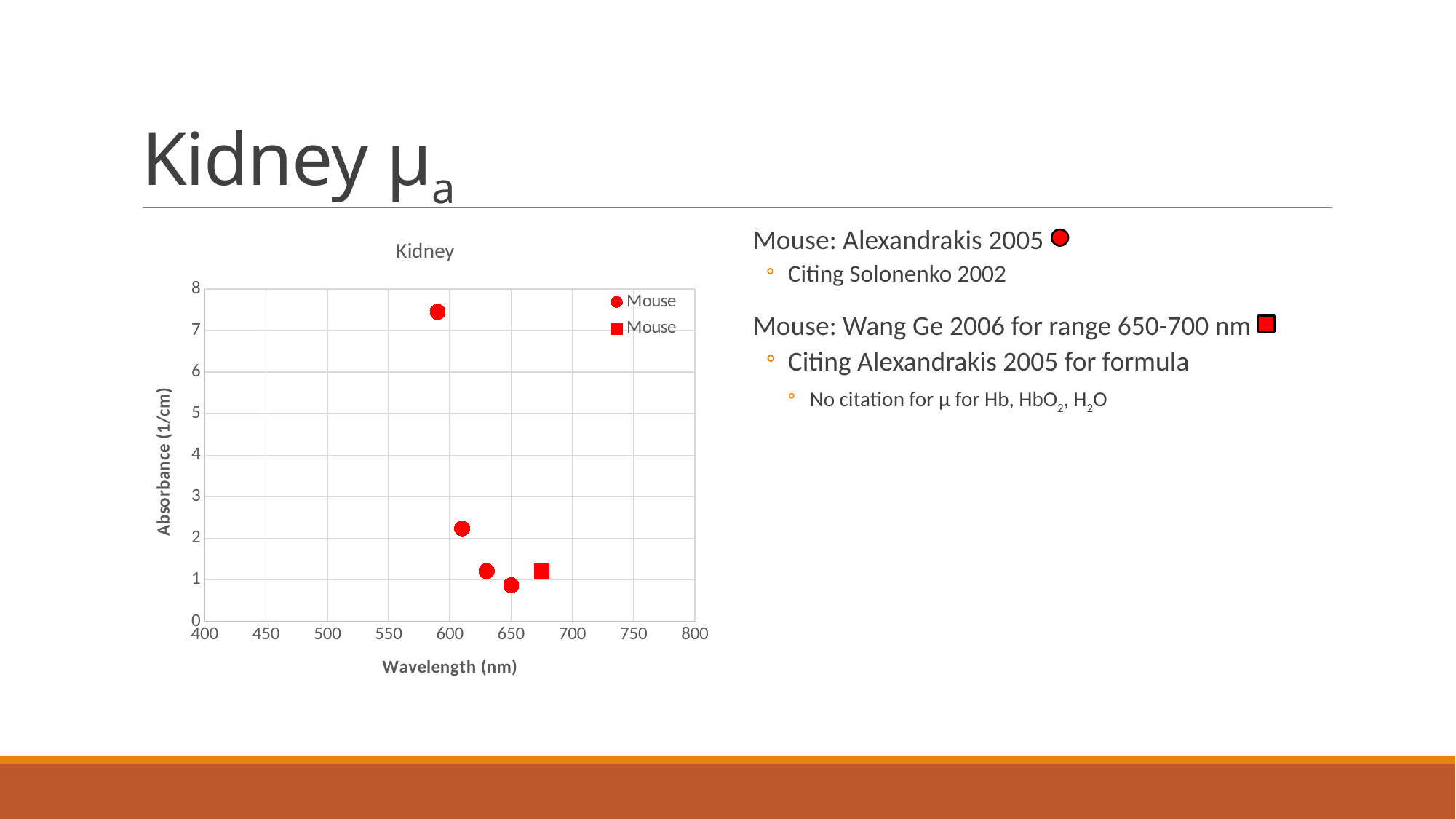
Is the absorbance of the circle point near 610 nm greater or less than 3? less For the circle-marker series, does absorbance rise or fall as wavelength increases? fall Is the absorbance of the circle point near 650 nm greater or less than 1? less Is the absorbance of the square point near 675 nm greater or less than 1? greater What kind of chart is shown on the slide? scatter chart How many circle-marker data points are plotted on the chart? 4 How many series does the chart legend list? 2 What is the label of the x axis? Wavelength (nm) Which point has the highest absorbance on the chart? the circle point near 590 nm How many data points are plotted on the chart in total? 5 What is the title of the chart? Kidney